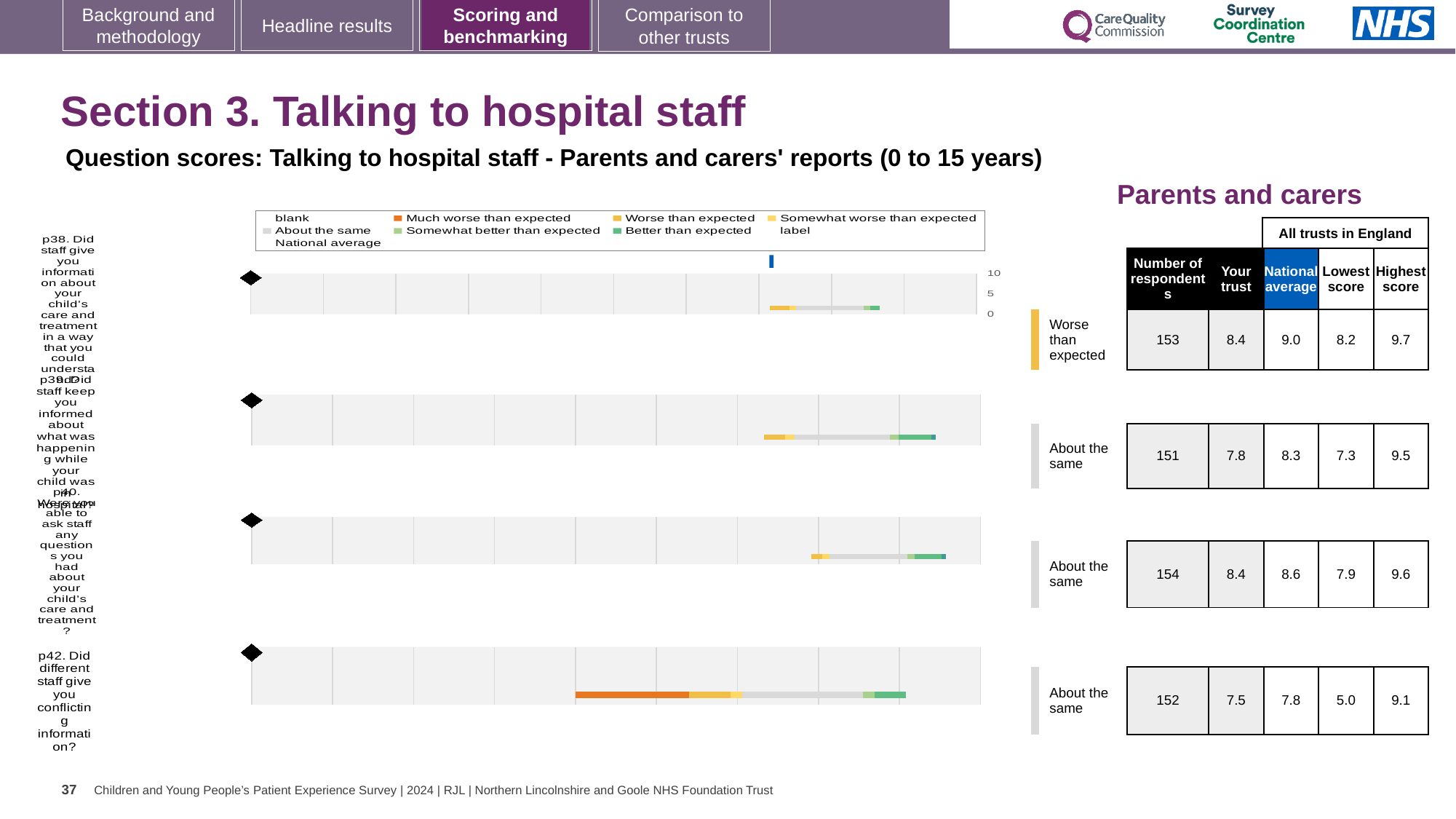
According to the benchmark label next to the chart, how is the trust's score for p42 (conflicting information) rated? About the same For p38, what is the difference between the national average and the 'Your trust' score? 0.6 In the table beside the chart, what is the 'Your trust' score for p38? 8.4 According to the benchmark label next to the chart, how is the trust's score for p38 (information about your child's care and treatment) rated? Worse than expected In the table beside the chart, what is the national average for p39 (staff keeping you informed)? 8.3 In the table beside the chart, what is the lowest score among all trusts in England for p42? 5.0 Which colour does the legend use for 'Much worse than expected'? orange Which question row has the lowest 'Your trust' score in the table? p42 (7.5) What kind of chart is used to show the question scores on this slide? bar chart Which question row has the highest number of respondents in the table? p40 (154) How many survey questions (rows) are plotted in the chart? 4 For p39, which is larger: the 'Your trust' score or the national average? National average